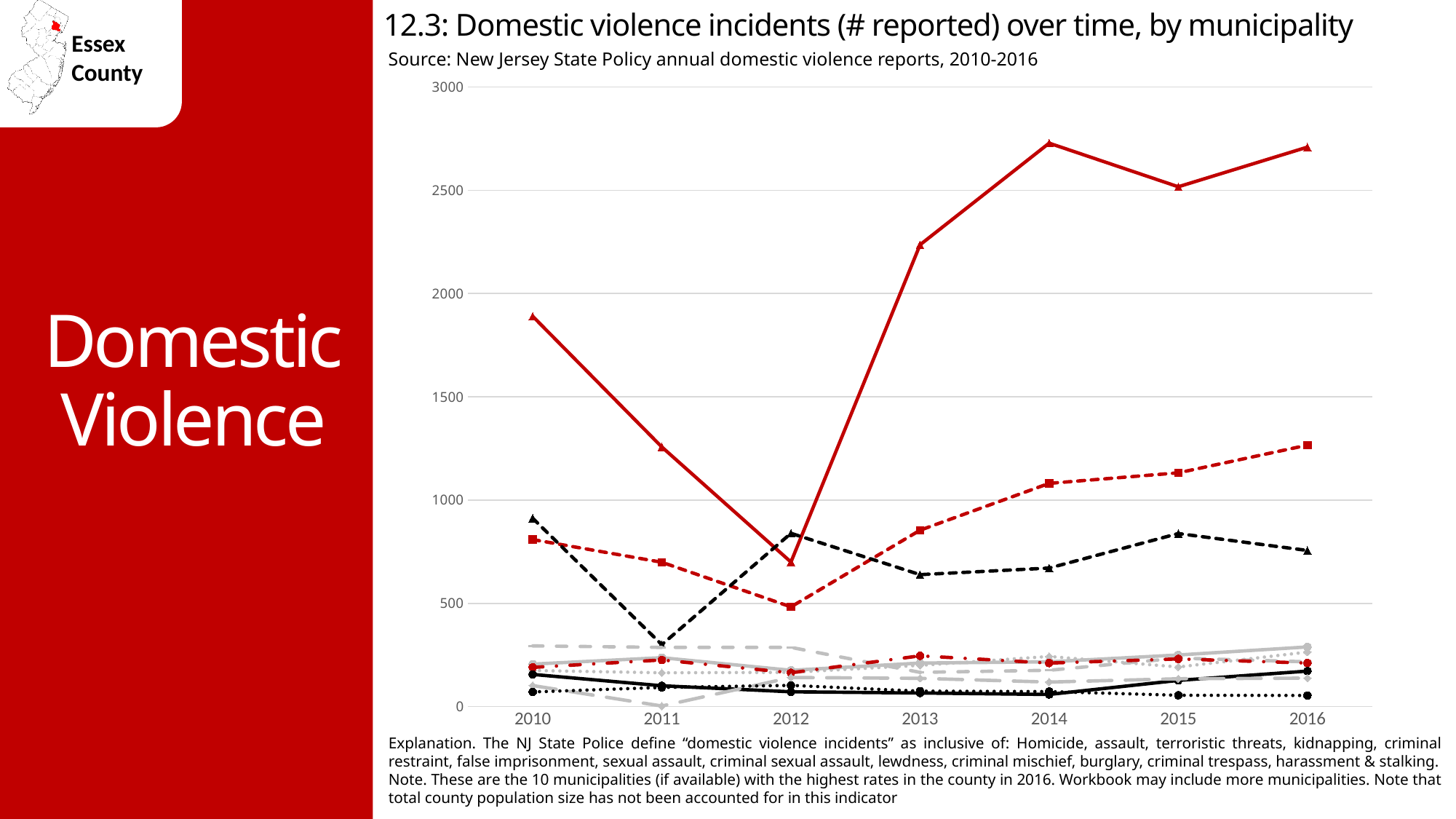
What is the last year shown on the x axis? 2016 What kind of chart is shown on the slide? Line chart What is the highest value labelled on the y axis? 3000 Is the value of the solid red line with triangle markers in 2012 greater or less than 1000? less Is the value of the solid red line with triangle markers in 2014 greater or less than 2500? greater How many years are shown along the x axis of the chart? 7 Is the value of the dashed red line with square markers in 2016 greater or less than 1000? greater What is the first year shown on the x axis? 2010 Between 2012 and 2014, does the solid red line with triangle markers rise or fall? Rise What is the title of the chart on the slide? 12.3: Domestic violence incidents (# reported) over time, by municipality